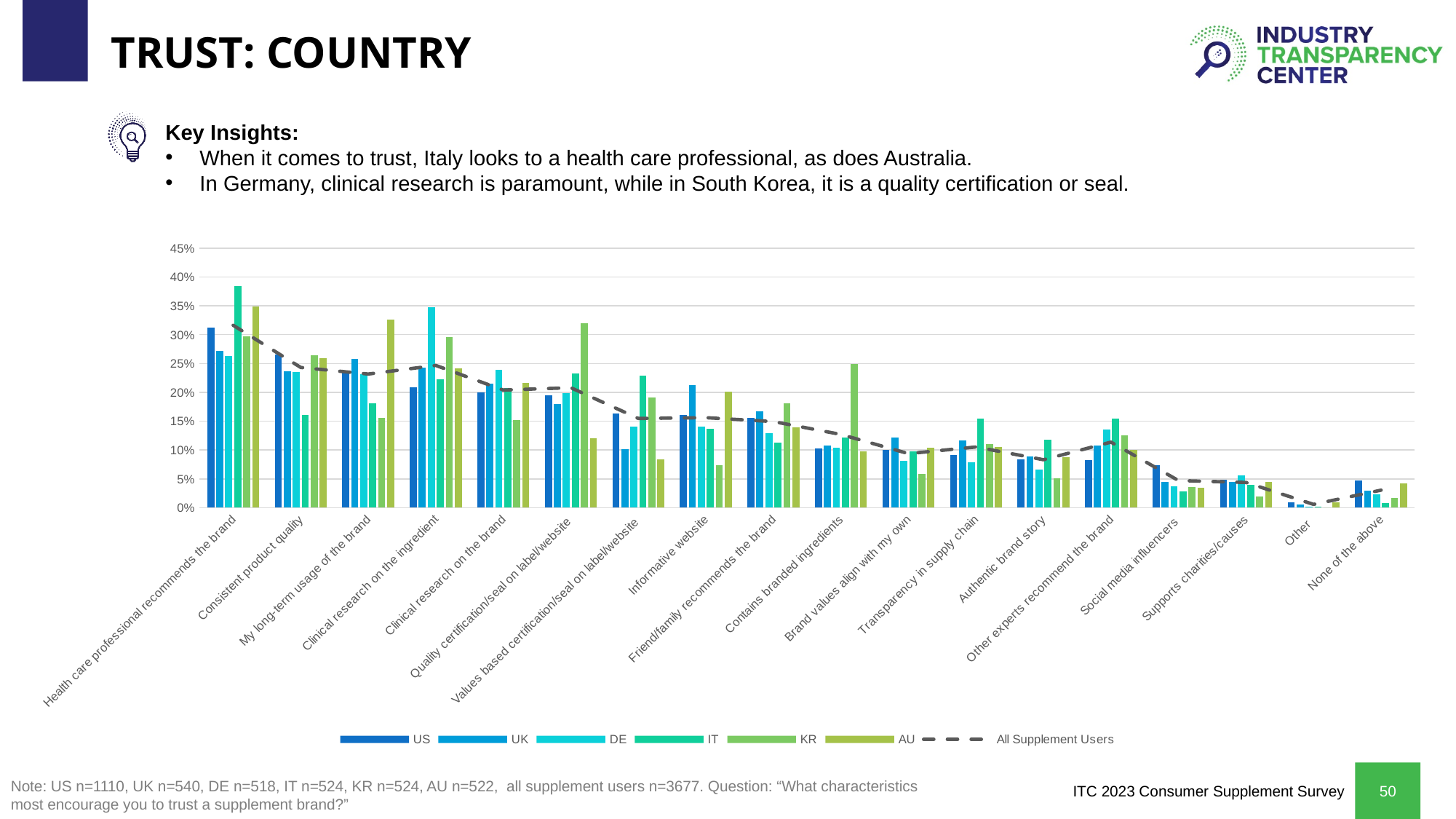
Which series is drawn as a dashed line rather than bars? All Supplement Users Which country has the highest value for 'Clinical research on the ingredient'? DE Does the 'All Supplement Users' dashed line generally rise or fall from left to right across the categories? Fall For 'Informative website', which is larger, the US value or the AU value? AU Is the US value for 'Other' greater or less than 5%? less Which country has the highest value for 'Quality certification/seal on label/website'? KR Is the IT value for 'Health care professional recommends the brand' greater or less than 35%? greater How many categories are shown along the x axis of the chart? 18 Which country has the lowest value for 'Informative website'? KR Which country has the highest value for 'Health care professional recommends the brand'? IT What kind of chart is shown on the slide? Bar and line chart How many series does the chart legend list? 7